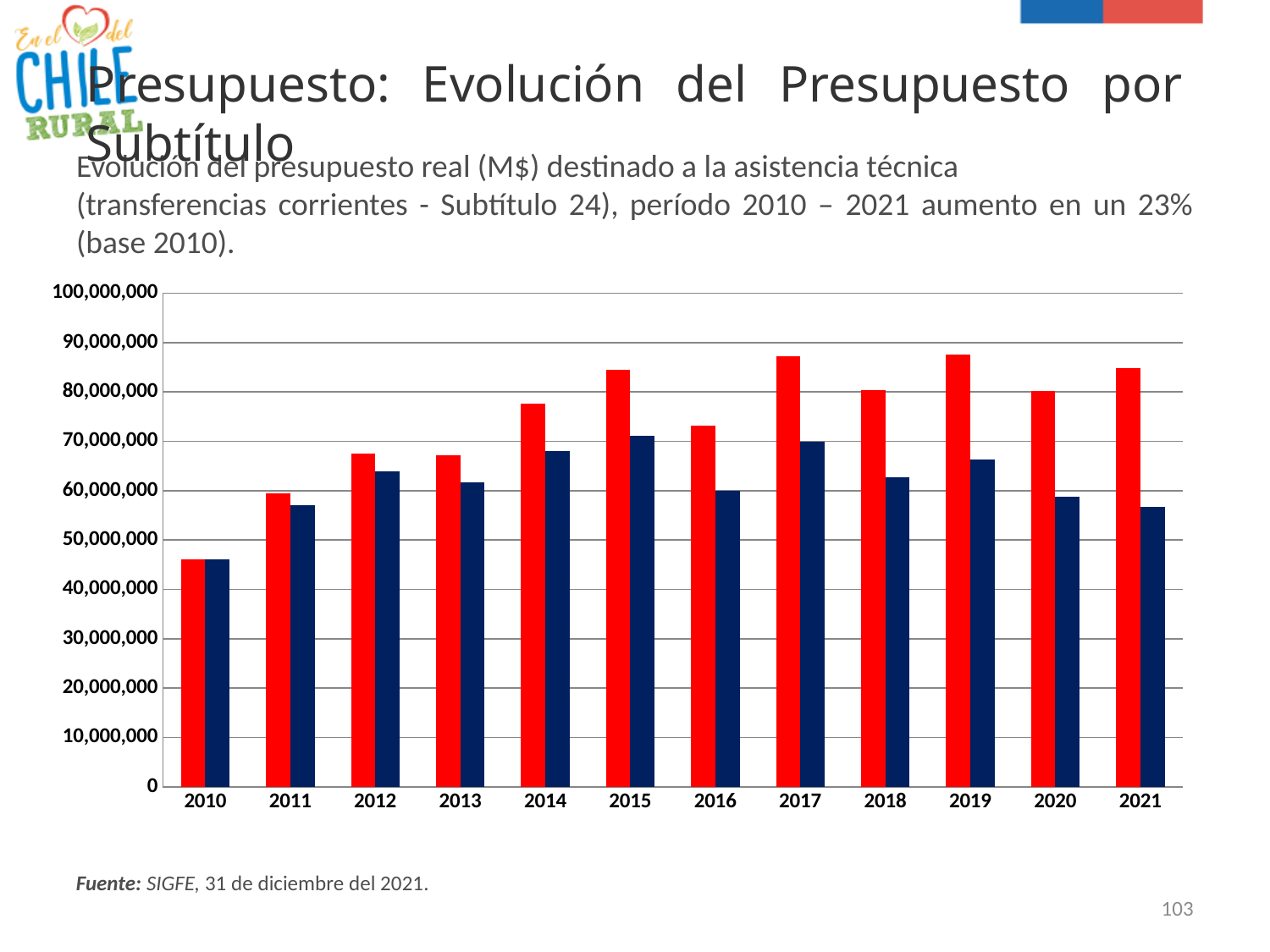
Is the value of the red bar for 2017 greater or less than 80,000,000? greater What is the highest value shown on the y axis of the chart? 100,000,000 What kind of chart is shown on the slide? bar chart Which year has the lowest dark blue bar in the chart? 2010 Is the value of the red bar for 2010 greater or less than 50,000,000? less Do the red bars rise or fall from 2010 to 2015? rise Is the value of the dark blue bar for 2021 greater or less than 60,000,000? less In 2021, which bar is larger, the red bar or the dark blue bar? the red bar How many years are shown on the x axis of the chart? 12 Which is larger, the red bar for 2015 or the red bar for 2016? 2015 Which year has the lowest red bar in the chart? 2010